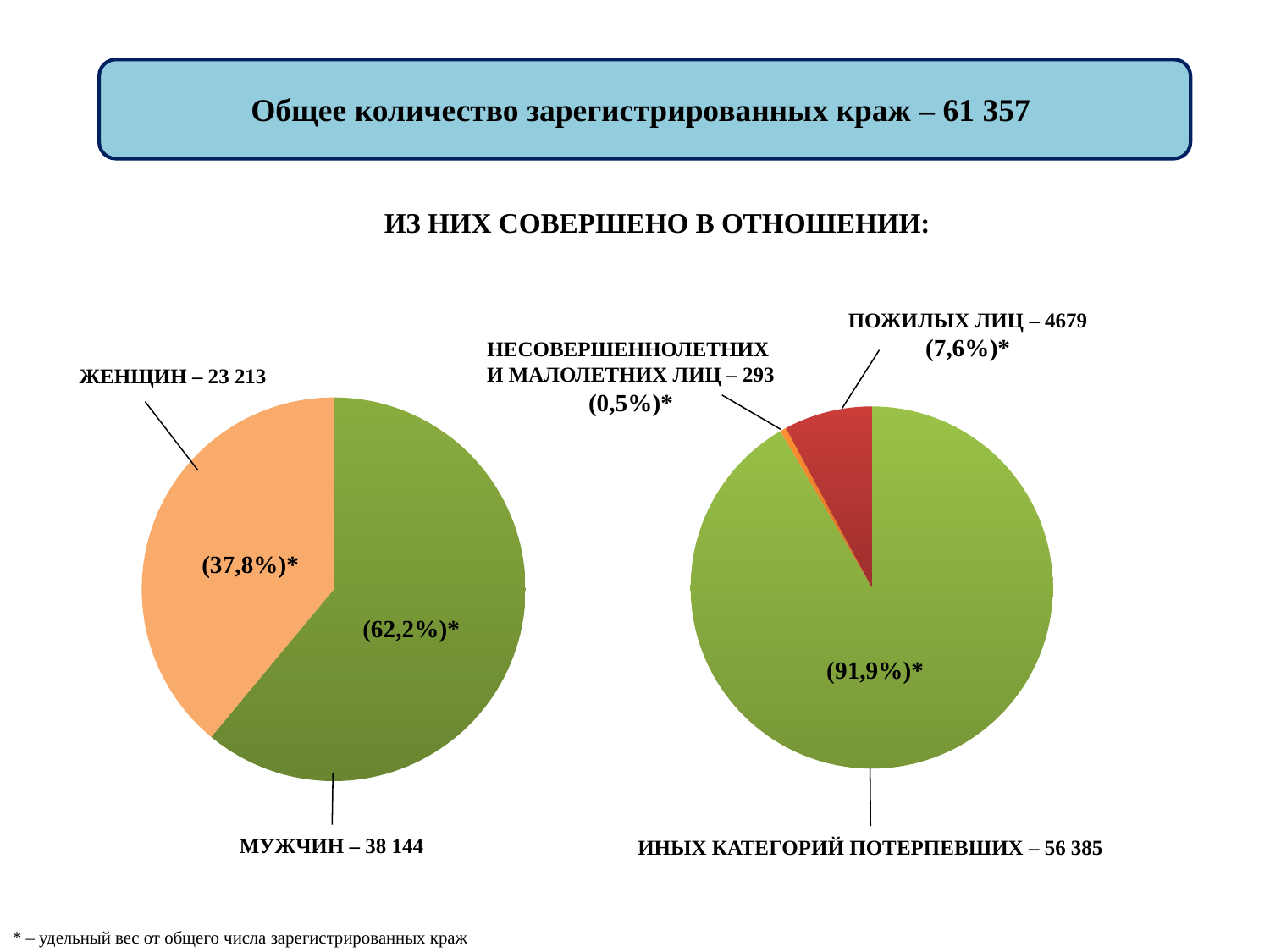
What total number of registered thefts is stated in the heading above the charts? 61 357 How many slices does the right pie chart have? 3 What kind of chart is the left chart on the slide? pie chart In the left pie chart, which category has the larger value, ЖЕНЩИН or МУЖЧИН? МУЖЧИН In the right pie chart, which category has the largest value? ИНЫХ КАТЕГОРИЙ ПОТЕРПЕВШИХ In the right pie chart, what share of the total do thefts against minors (НЕСОВЕРШЕННОЛЕТНИХ И МАЛОЛЕТНИХ ЛИЦ) represent? 0,5% In the left pie chart, how many thefts were committed against men (МУЖЧИН)? 38 144 In the left pie chart, how many thefts were committed against women (ЖЕНЩИН)? 23 213 In the right pie chart, which category has the smallest value? НЕСОВЕРШЕННОЛЕТНИХ И МАЛОЛЕТНИХ ЛИЦ In the left pie chart, what share of the total do thefts against men (МУЖЧИН) represent? 62,2% In the left pie chart, what is the difference between the number of thefts against men (38 144) and against women (23 213)? 14 931 In the right pie chart, how many thefts were committed against elderly persons (ПОЖИЛЫХ ЛИЦ)? 4679